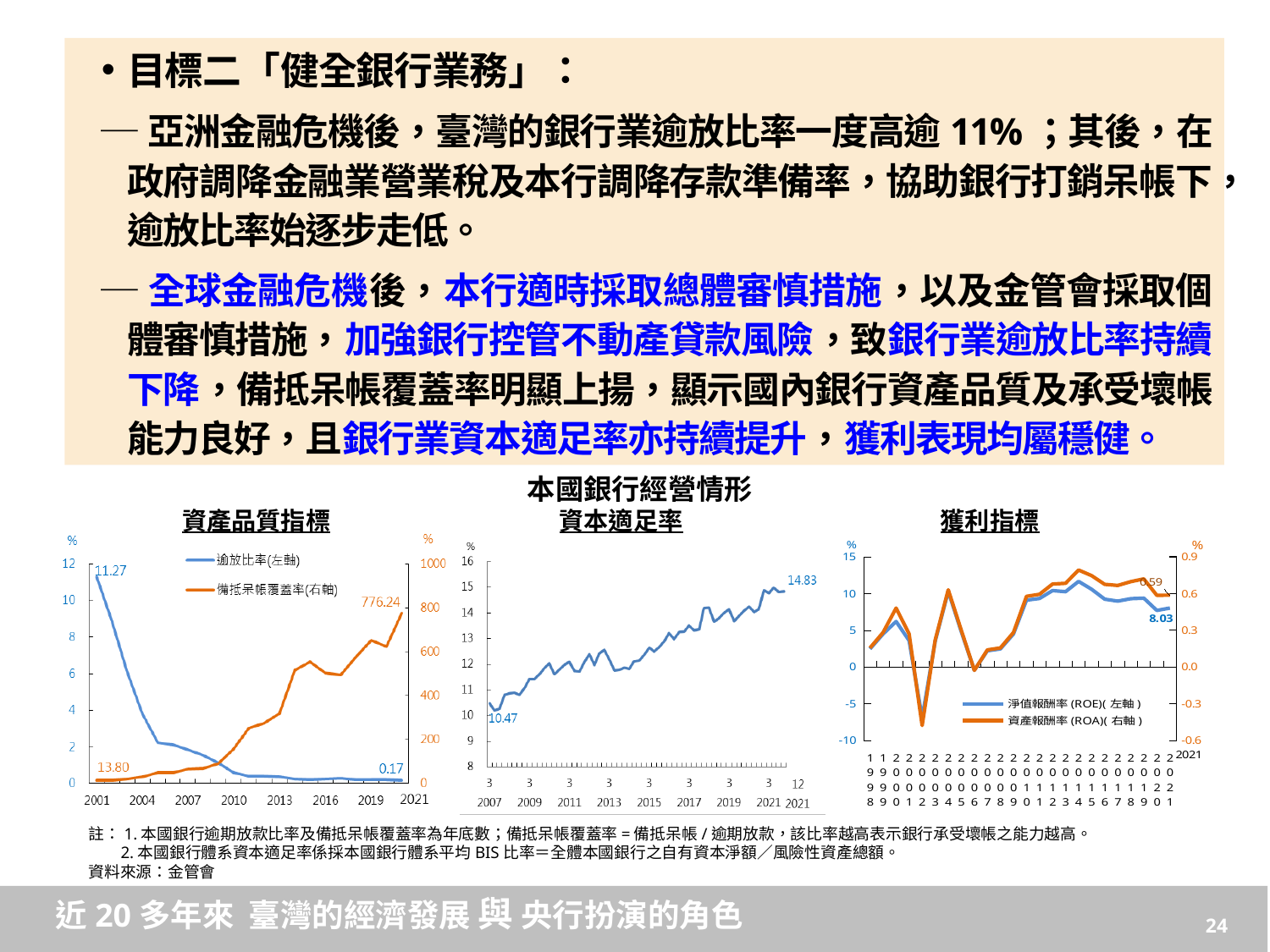
In the 獲利指標 chart, what is the labelled final value of 淨值報酬率 (ROE)? 8.03 In the 資產品質指標 chart, what is the difference between the 2001 and 2021 labelled values of 逾放比率? 11.10 In the 資產品質指標 chart, what is the last labelled value of 逾放比率 in 2021? 0.17 In the 資本適足率 chart, what is the difference between the 2021 and 2007 labelled values? 4.36 What kind of chart is the 資本適足率 chart? line chart In the 資產品質指標 chart, does 逾放比率 rise or fall from 2001 to 2021? fall In the 資本適足率 chart, what is the labelled value at the start of the series in 2007? 10.47 In the 資產品質指標 chart, what is the labelled value of 備抵呆帳覆蓋率 at the end of the series? 776.24 In the 資產品質指標 chart, what is the first labelled value of 逾放比率 in 2001? 11.27 In the 資產品質指標 chart, what is the first labelled value of 備抵呆帳覆蓋率? 13.80 In the 資本適足率 chart, what is the labelled value at the end of the series in 2021? 14.83 In the 資產品質指標 chart, how many series does the legend list? 2